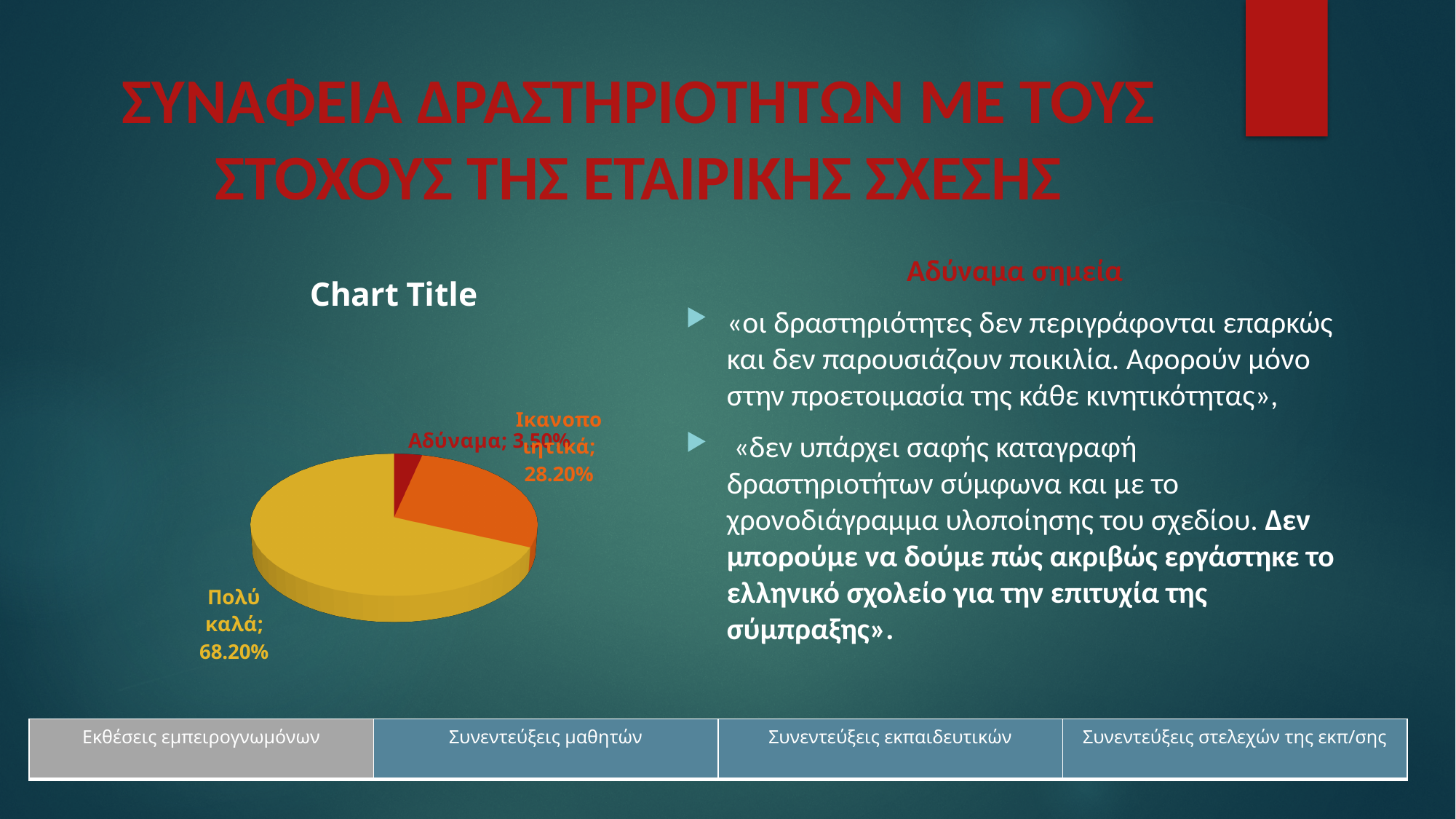
What is the title of the chart? Chart Title Which is larger, the "Ικανοποιητικά" slice or the "Αδύναμα" slice? Ικανοποιητικά What percentage is shown for the "Αδύναμα" slice? 3.50% What percentage is shown for the "Πολύ καλά" slice? 68.20% What is the difference in percentage points between the "Ικανοποιητικά" and "Αδύναμα" slices? 24.70 percentage points Which slice of the pie chart is the largest? Πολύ καλά What percentage is shown for the "Ικανοποιητικά" slice? 28.20% What is the difference in percentage points between the "Πολύ καλά" and "Ικανοποιητικά" slices? 40 percentage points How many slices does the pie chart have? 3 Which slice of the pie chart is the smallest? Αδύναμα What kind of chart is shown on the slide? Pie chart What colour is the "Πολύ καλά" slice? Yellow